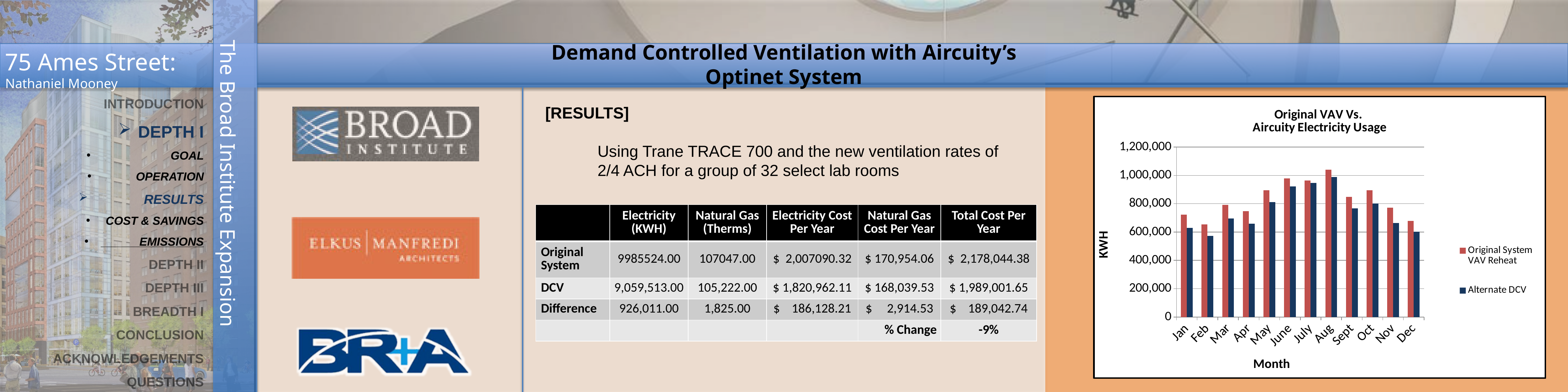
What is the title of the chart on the slide? Original VAV Vs. Aircuity Electricity Usage Which month has the lowest value for the Alternate DCV series? Feb Which month has the highest value for the Original System VAV Reheat series? Aug How many series does the chart's legend list? 2 How many months are plotted along the x axis of the chart? 12 Is the Alternate DCV value for June greater or less than 800,000? greater Is the Original System VAV Reheat value for Aug greater or less than 1,000,000? greater What label is shown on the y axis of the chart? KWH Is the Alternate DCV value for Jan greater or less than 800,000? less What kind of chart is shown on the slide? bar chart In Aug, which series has the larger value: Original System VAV Reheat or Alternate DCV? Original System VAV Reheat Do the Original System VAV Reheat values generally rise or fall from Jan to Aug? rise